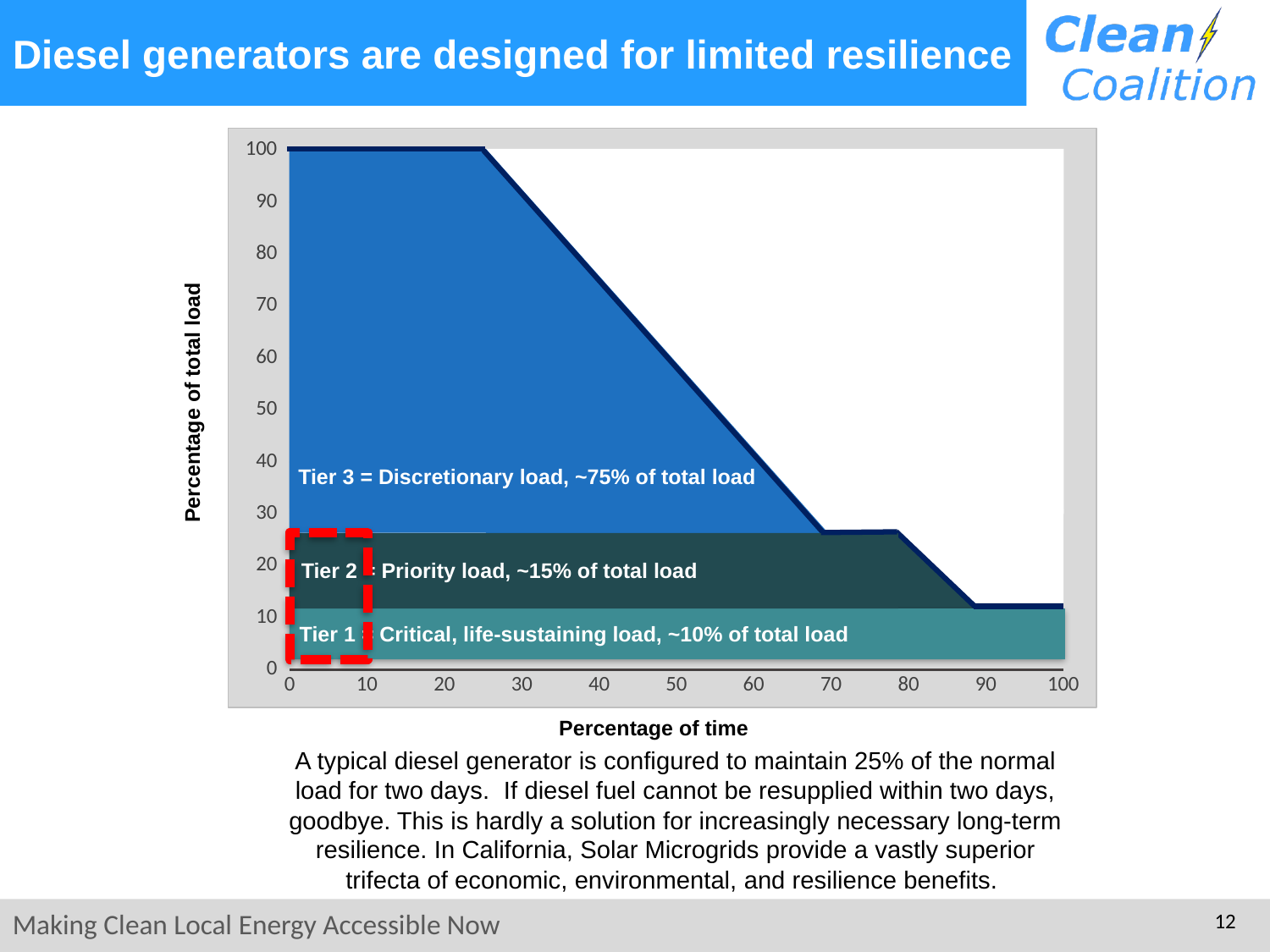
Do the plotted values rise or fall as percentage of time increases? fall Is the percentage of total load at 95% of time greater or less than 20? less What is the title of the x axis of the chart? Percentage of time Is the percentage of total load at 50% of time greater or less than 40? greater Is the percentage of total load at 10% of time greater or less than 90? greater What is the title of the y axis of the chart? Percentage of total load According to the label on the chart, what share of total load is Tier 2 (Priority load)? ~15% of total load Which tier labelled on the chart accounts for the largest share of total load? Tier 3 According to the label on the chart, what share of total load is Tier 3 (Discretionary load)? ~75% of total load What kind of chart is shown on the slide? area chart What is the percentage of total load at 0% of time? 100 According to the label on the chart, what share of total load is Tier 1 (Critical, life-sustaining load)? ~10% of total load